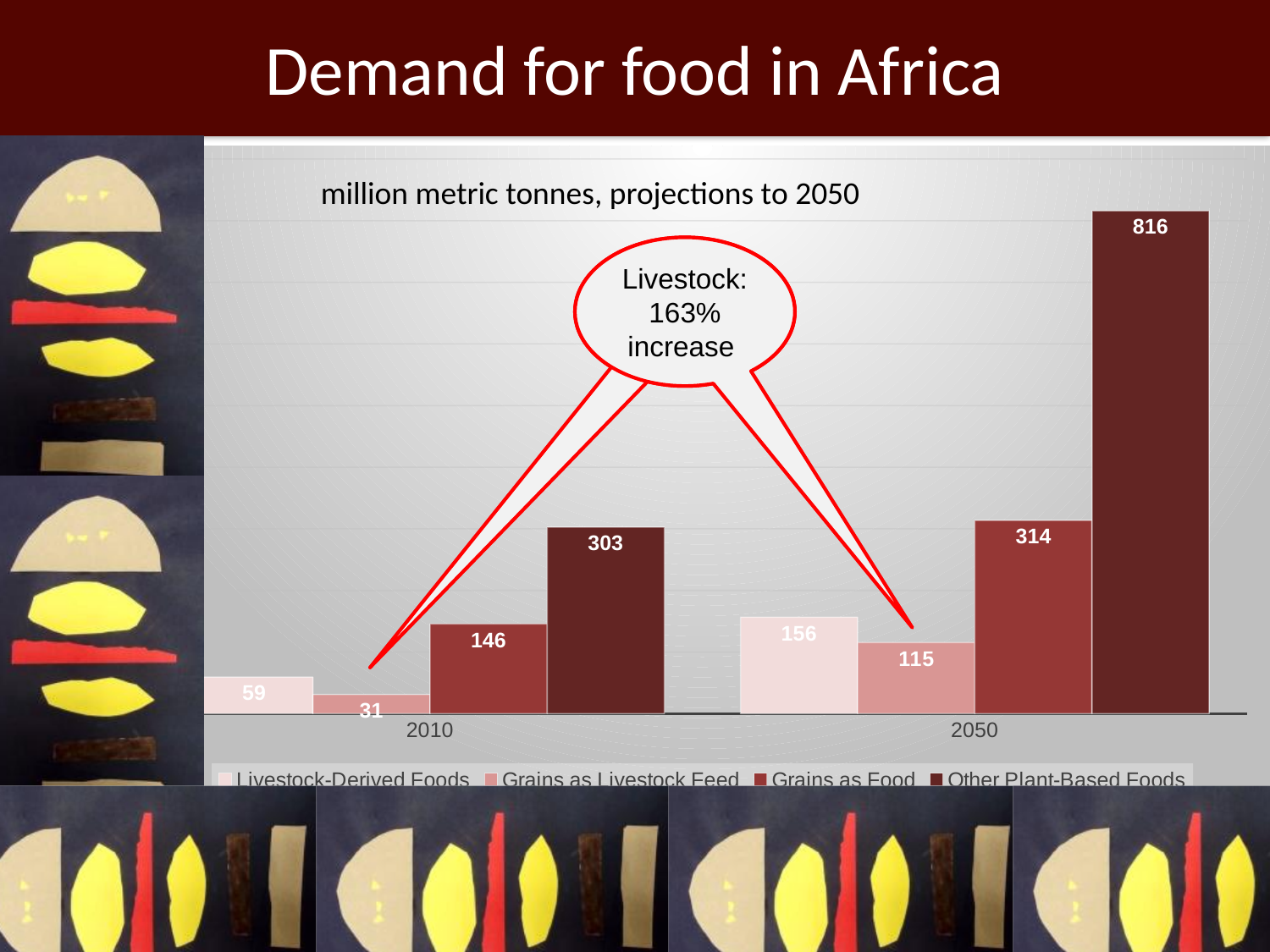
What is the difference between the Other Plant-Based Foods values for 2050 and 2010? 513 What kind of chart is shown on the slide? Bar chart What is the value for Grains as Livestock Feed in 2010? 31 What percentage increase does the callout on the chart state for livestock? 163% What is the value for Other Plant-Based Foods in 2050? 816 What is the value for Grains as Food in 2010? 146 Which is larger: Livestock-Derived Foods in 2050 or Grains as Food in 2010? Livestock-Derived Foods in 2050 Which series has the highest value in 2050? Other Plant-Based Foods Which series has the lowest value in 2010? Grains as Livestock Feed What is the difference between Grains as Food and Grains as Livestock Feed in 2050? 199 How many series does the legend list? 4 What is the value for Livestock-Derived Foods in 2050? 156